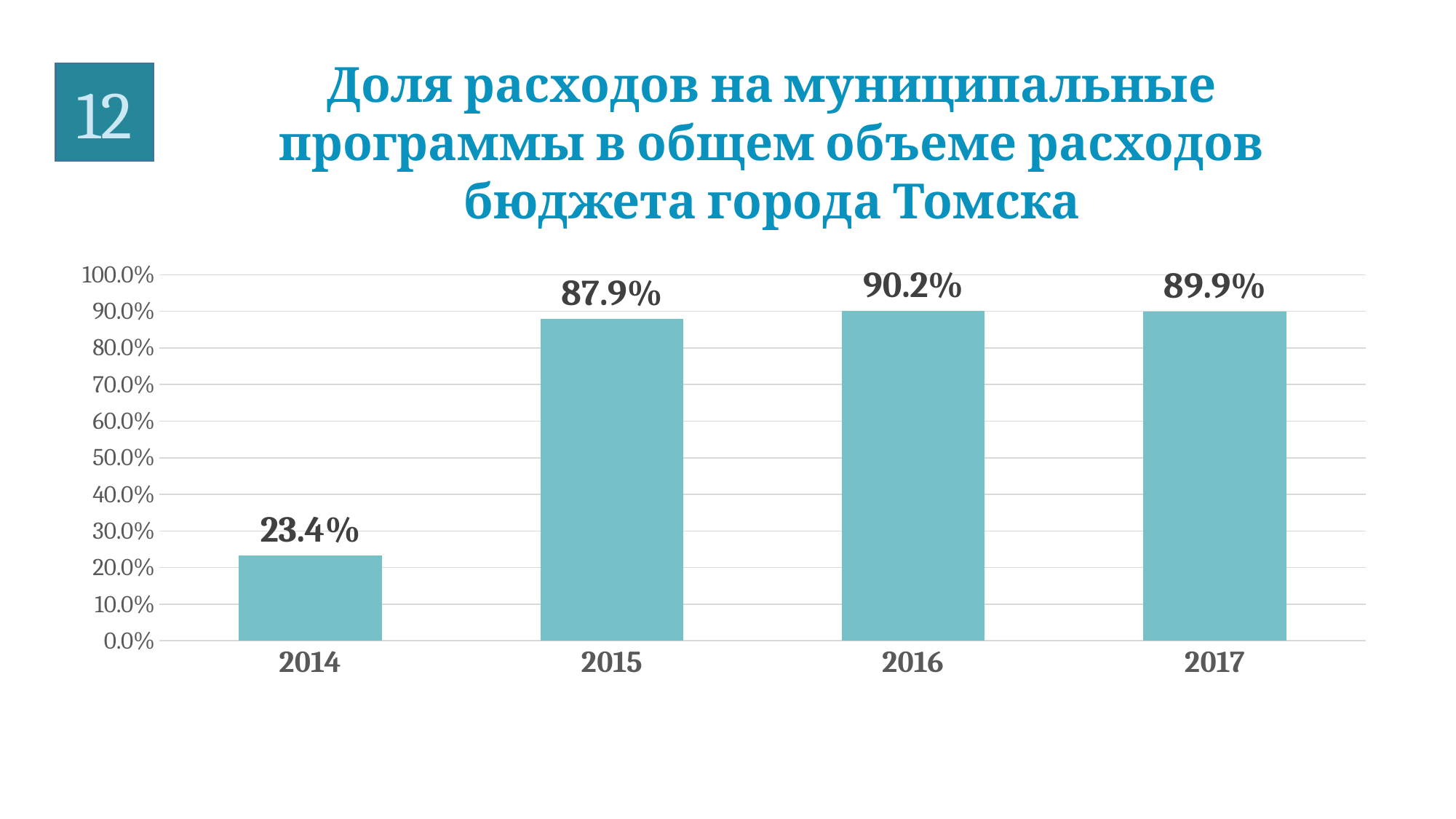
Which is larger, the value for 2014 or the value for 2015? 2015 What is the difference between the values for 2016 and 2017? 0.3% What is the value for 2014? 23.4% What is the value for 2017? 89.9% What is the difference between the values for 2015 and 2014? 64.5% How many years are shown on the x axis? 4 Which year has the lowest value? 2014 What is the value for 2016? 90.2% What is the value for 2015? 87.9% Which year has the highest value? 2016 What is the title of the chart? Доля расходов на муниципальные программы в общем объеме расходов бюджета города Томска What kind of chart is shown on the slide? bar chart